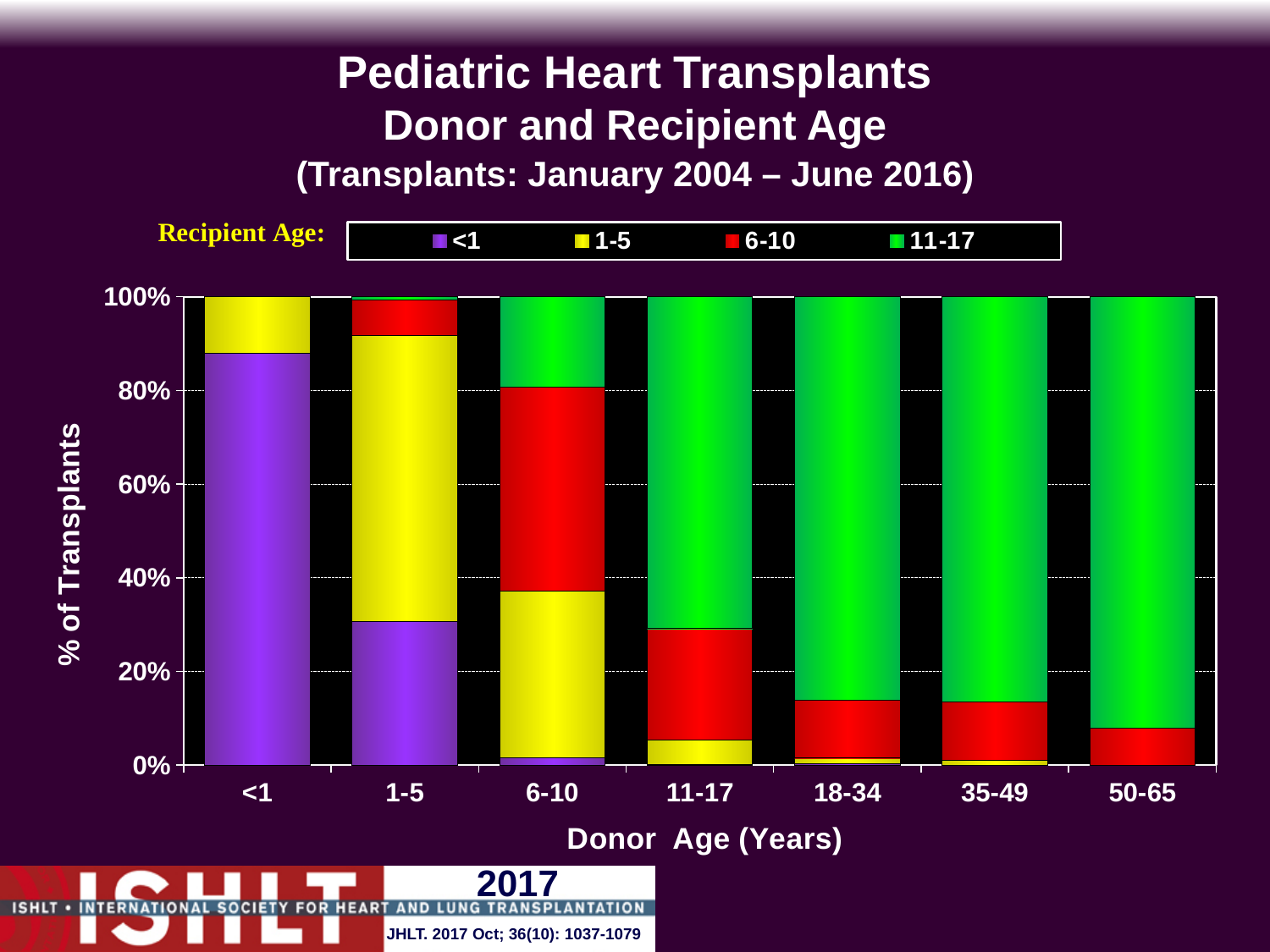
Which donor age group has the largest share of recipients aged 6-10? 6-10 Which is larger: the share of recipients aged 1-5 for donor age 1-5 or for donor age 6-10? Donor age 1-5 Is the share of recipients aged 11-17 for donor age 50-65 greater or less than 80%? greater Is the share of recipients aged <1 for donor age <1 greater or less than 80%? greater Which donor age group has the largest share of recipients aged 11-17? 50-65 Is the share of recipients aged <1 for donor age 1-5 greater or less than 40%? less What is the title of the y axis? % of Transplants What kind of chart is shown on the slide? Stacked bar chart Does the share of recipients aged 11-17 generally rise or fall as donor age increases along the x axis? Rise How many recipient age groups does the legend list? 4 How many donor age groups are shown on the x axis? 7 Which donor age group has the largest share of recipients aged <1? <1